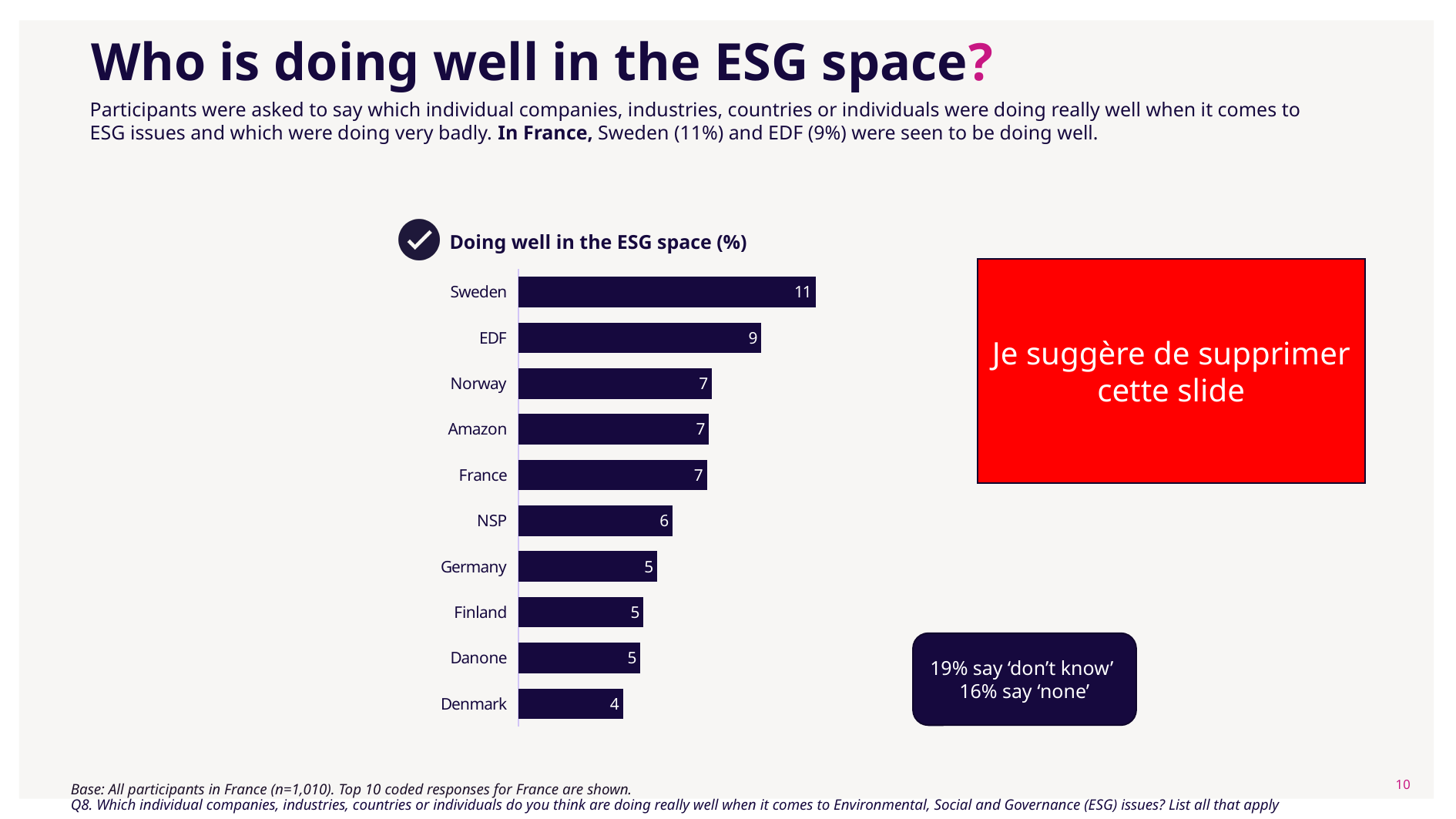
What is the value for NSP in the chart? 6 Which category has the lowest value in the chart? Denmark What is the value for EDF in the chart? 9 What is the difference between the values for Sweden and EDF? 2 Which has a larger value, EDF or Amazon? EDF What kind of chart is shown on the slide? Bar chart What is the title of the chart? Doing well in the ESG space (%) How many categories are shown in the chart? 10 What is the difference between the values for Norway and Denmark? 3 Which category has the highest value in the chart? Sweden What is the value for Denmark in the chart? 4 What is the value for Sweden in the 'Doing well in the ESG space (%)' chart? 11